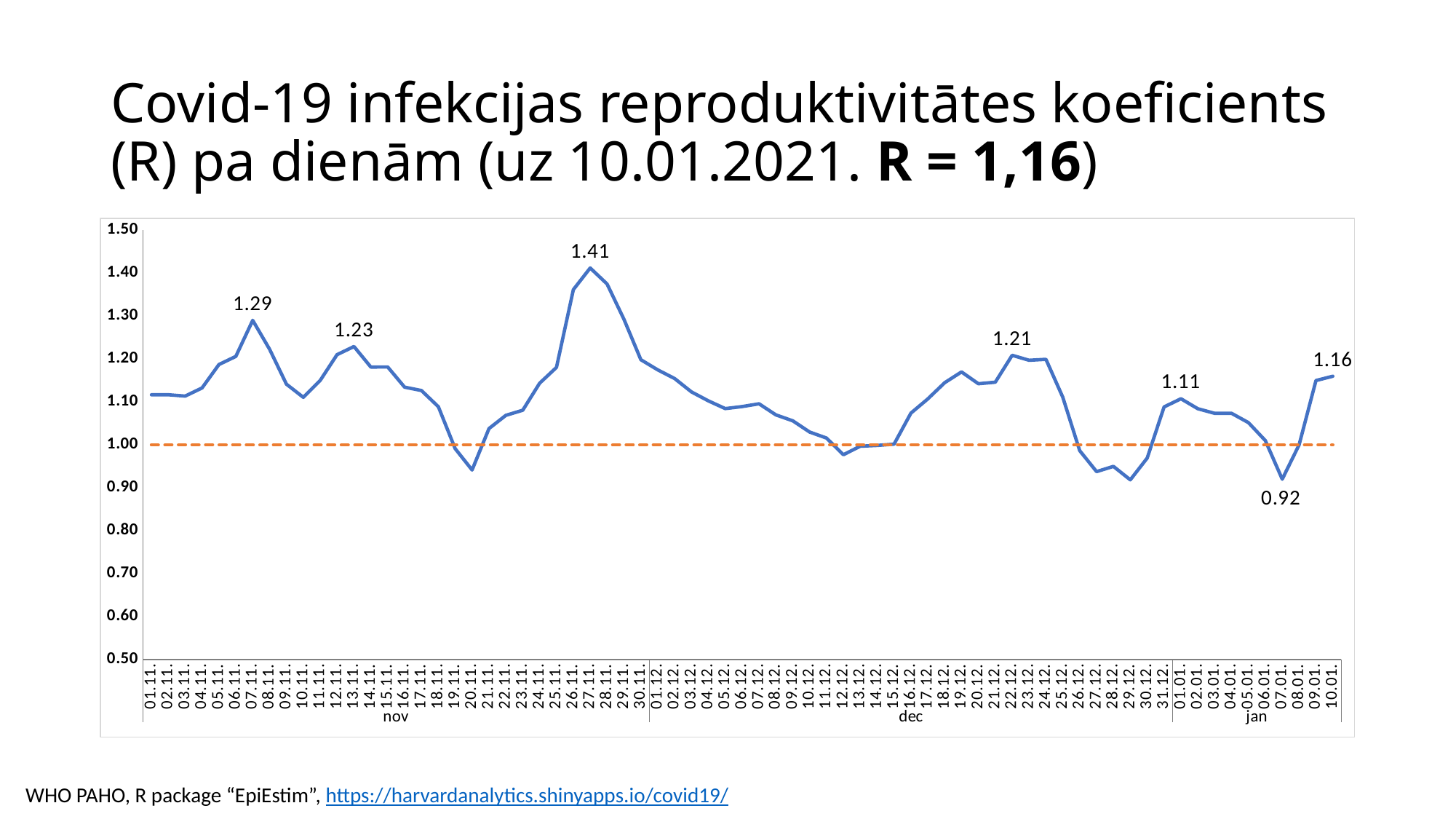
At what level is the dashed orange horizontal reference line drawn? 1.00 Which is larger, the labelled value on 07.11. or the labelled value on 13.11.? 07.11. (1.29) Does the R value rise or fall between 27.11. and 12.12.? fall What is the R value labelled on 10.01., the last point of the chart? 1.16 What is the R value labelled on 27.11.? 1.41 What kind of chart is shown on the slide? line chart What is the difference between the highest labelled value (1.41) and the lowest labelled value (0.92)? 0.49 What is the R value labelled on 07.01.? 0.92 Is the R value on 20.11. greater or less than 1.00? less On which date does the chart reach its highest R value? 27.11. What is the R value labelled on 22.12.? 1.21